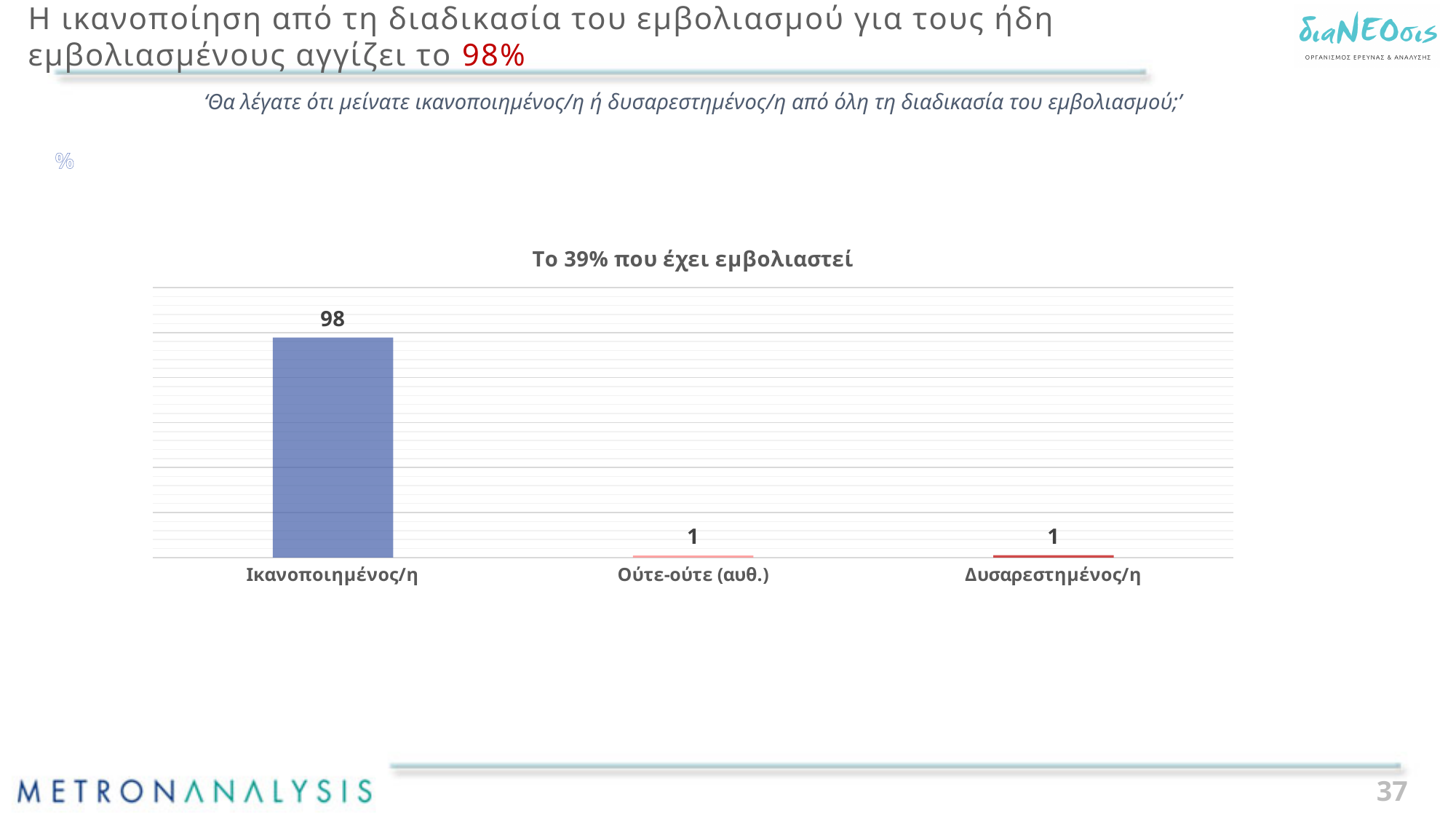
What colour is the bar for Ικανοποιημένος/η? blue What is the value for Δυσαρεστημένος/η? 1 Which category has the highest value? Ικανοποιημένος/η What kind of chart is shown on the slide? bar chart What is the title of the chart? Το 39% που έχει εμβολιαστεί What is the value for Ούτε-ούτε (αυθ.)? 1 What is the value for Ικανοποιημένος/η? 98 What is the total of the three values shown on the chart? 100 What is the difference between the values for Ικανοποιημένος/η and Δυσαρεστημένος/η? 97 How many categories are shown on the chart? 3 Which is larger, the value for Ικανοποιημένος/η or the value for Ούτε-ούτε (αυθ.)? Ικανοποιημένος/η